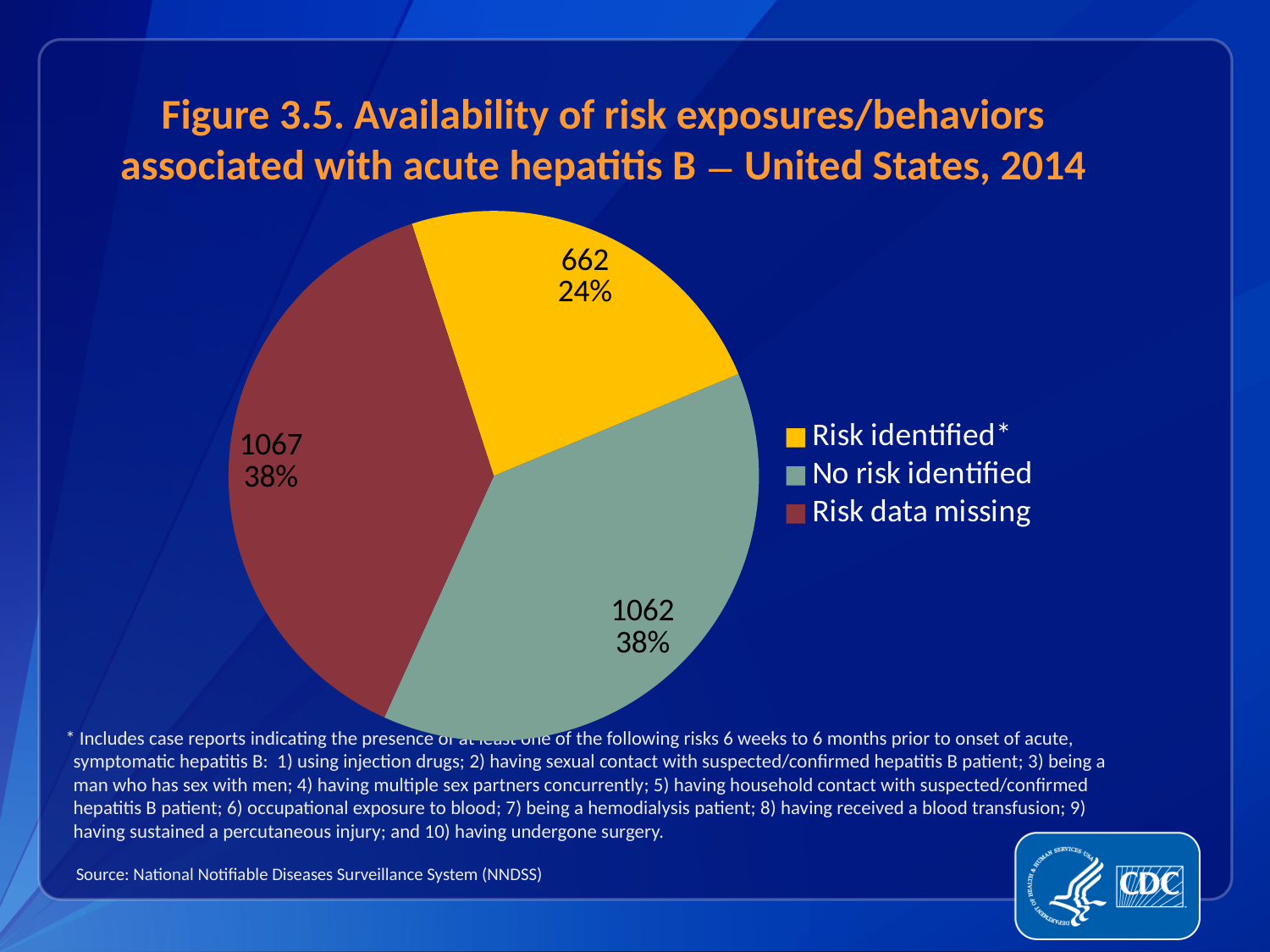
What is the number of cases with no risk identified? 1062 How many slices does the pie chart have? 3 How many entries does the legend list? 3 What percentage of cases had risk data missing? 38% What is the difference between the number of cases with risk data missing and the number with risk identified? 405 What is the number of cases with risk identified? 662 Which category has the smallest slice of the pie? Risk identified* Which colour represents the 'No risk identified' slice? teal green What is the total number of cases across all three slices? 2791 What percentage of cases had risk identified? 24% What is the number of cases with risk data missing? 1067 What kind of chart is shown on the slide? pie chart